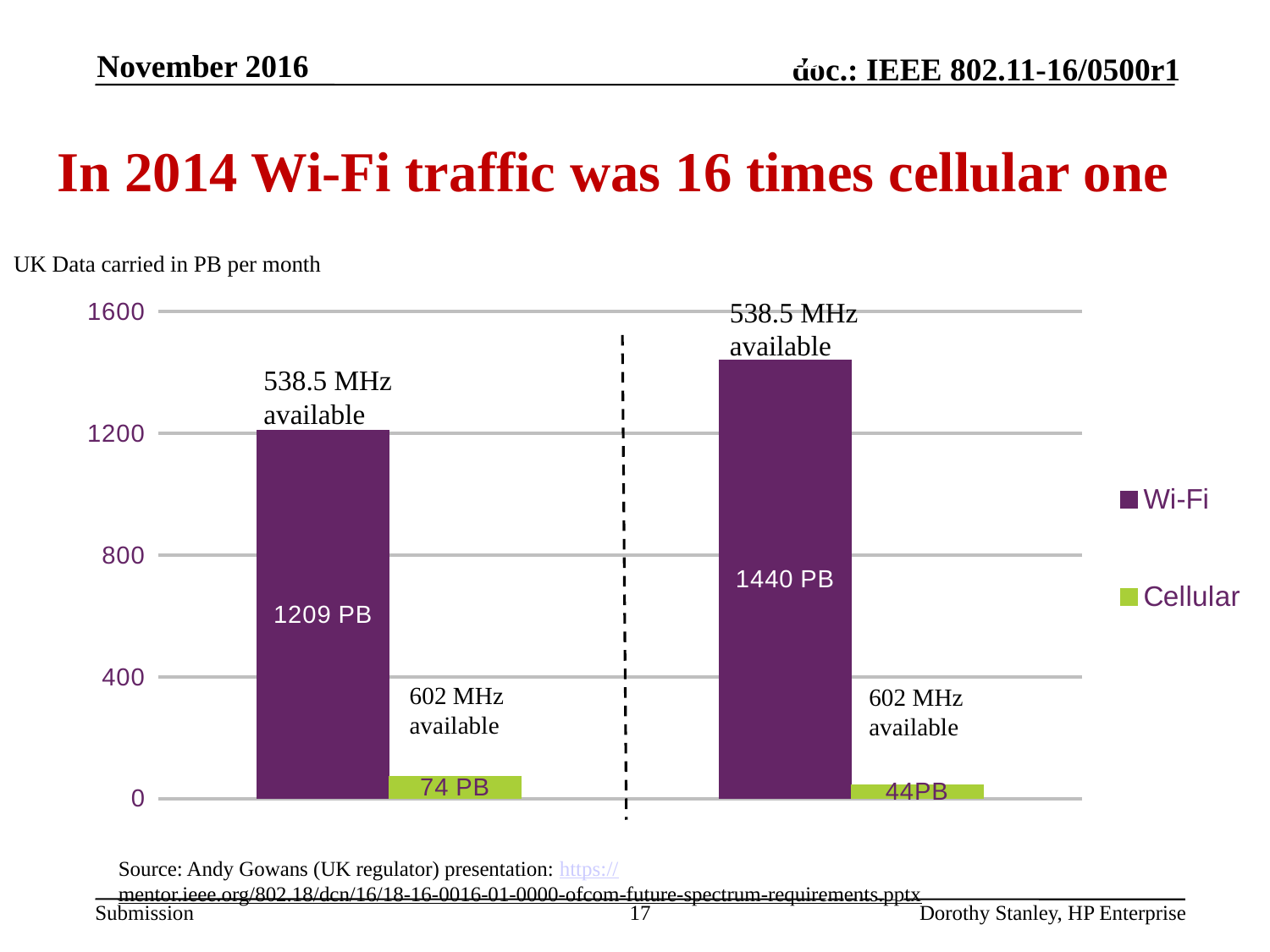
Which bar has the lowest value in the chart? Cellular in the right group (44PB) What is the difference between the Wi-Fi values of the right group and the left group? 231 PB What is the Cellular value in the right group of bars? 44PB Which is larger, the Cellular value in the left group or the Cellular value in the right group? the left group (74 PB) Is the Wi-Fi value in the left group greater or less than 1200? greater What is the Wi-Fi value in the right group of bars? 1440 PB What kind of chart is shown on the slide? bar chart Which bar has the highest value in the chart? Wi-Fi in the right group (1440 PB) How many series does the chart legend list? 2 What is the Cellular value in the left group of bars? 74 PB What are the two series named in the chart legend? Wi-Fi and Cellular What is the Wi-Fi value in the left group of bars? 1209 PB